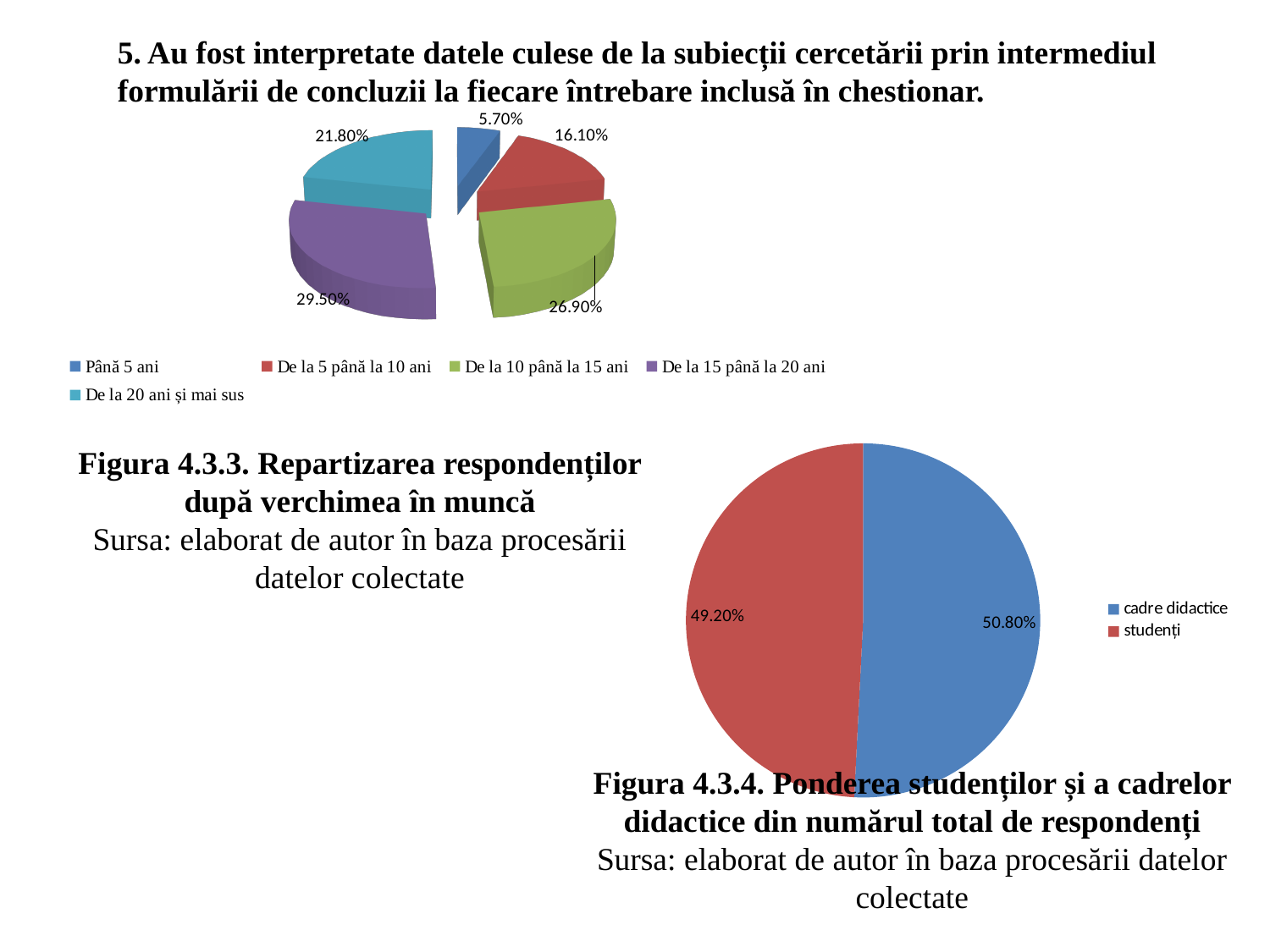
In the top chart (Figura 4.3.3), which category has the smallest share? Până 5 ani In the top chart (Figura 4.3.3), which is larger: 'De la 20 ani și mai sus' or 'De la 5 până la 10 ani'? De la 20 ani și mai sus In the top chart (Figura 4.3.3), what percentage of respondents have 'Până 5 ani' of work experience? 5.70% How many categories does the top chart (Figura 4.3.3) show? 5 In the top chart (Figura 4.3.3), what is the value for 'De la 20 ani și mai sus'? 21.80% In the top chart (Figura 4.3.3), what is the value for 'De la 15 până la 20 ani'? 29.50% In the top chart (Figura 4.3.3), which category has the largest share? De la 15 până la 20 ani What kind of chart is the top chart (Figura 4.3.3)? Pie chart In the bottom-right chart (Figura 4.3.4), what is the share of 'cadre didactice'? 50.80% In the top chart (Figura 4.3.3), what is the difference between 'De la 10 până la 15 ani' and 'De la 5 până la 10 ani'? 10.80% In the bottom-right chart (Figura 4.3.4), what is the share of 'studenți'? 49.20% How many entries does the legend of the bottom-right chart (Figura 4.3.4) list? 2